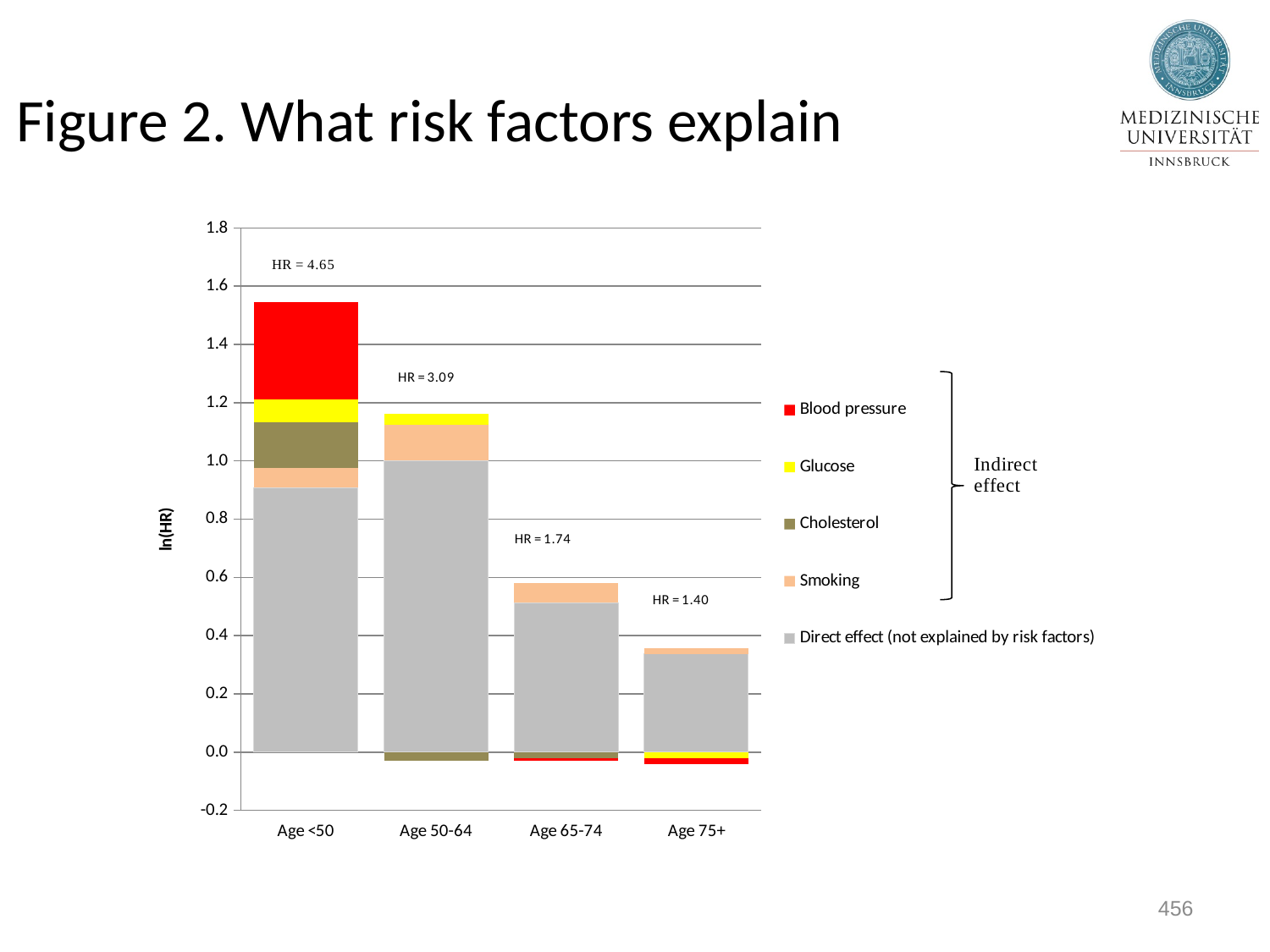
Which has the larger printed HR, Age 50-64 or Age 65-74? Age 50-64 What is the difference between the printed HR for Age <50 and the printed HR for Age 75+? 3.25 How many age groups are shown on the x axis? 4 What is the label on the y axis? ln(HR) Which age group has the highest printed HR? Age <50 What kind of chart is shown on the slide? bar chart Do the printed HR values rise or fall as age increases along the x axis? fall Which age group has the lowest printed HR? Age 75+ What HR value is printed for Age 65-74? HR = 1.74 Is the Direct effect value for Age 65-74 greater or less than 0.6? less How many series does the legend list? 5 What HR value is printed above the bar for Age <50? HR = 4.65